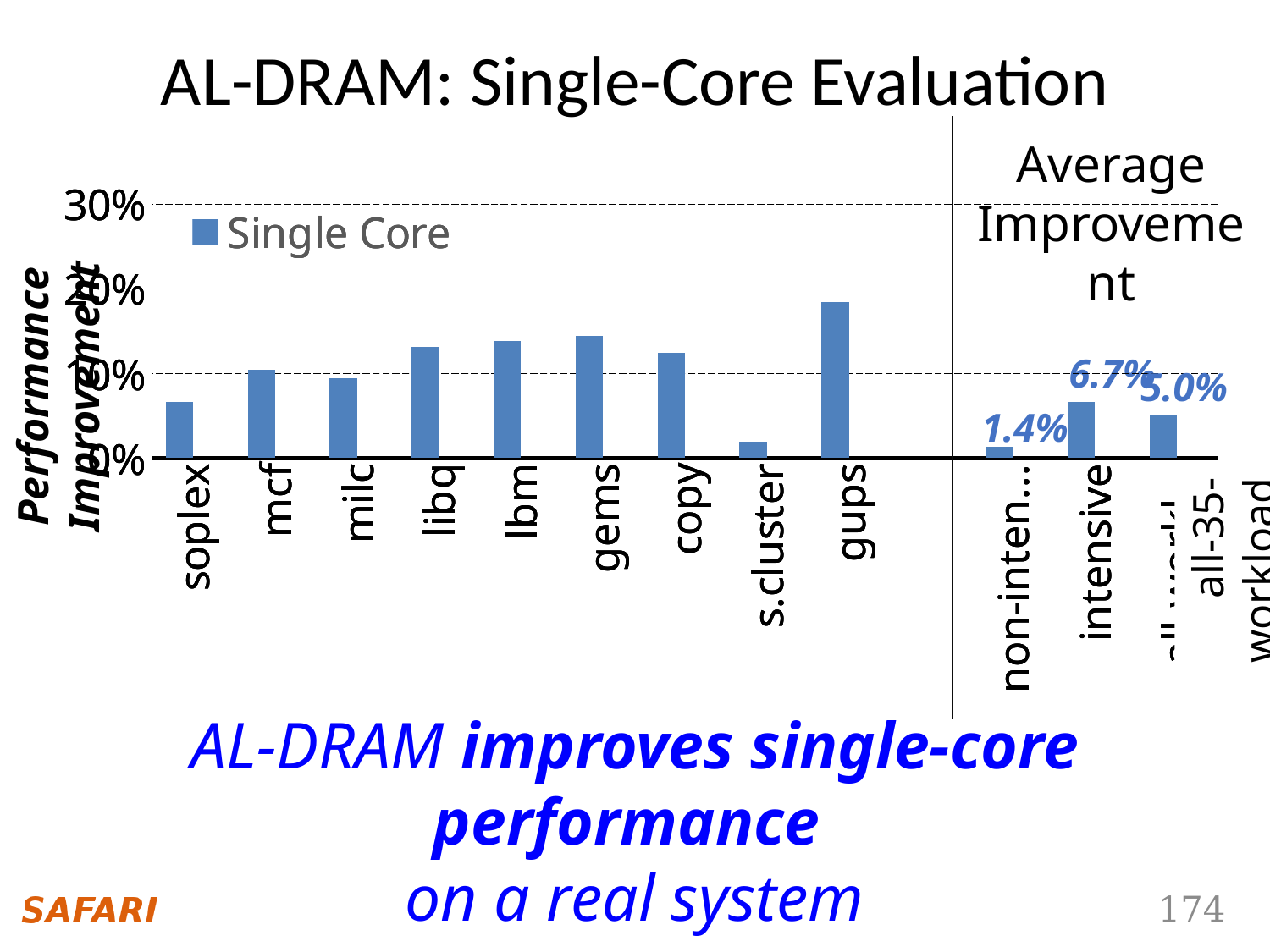
What is the performance improvement for the all-35-workload average? 5.0% Is the value for s.cluster greater or less than 10%? less Is the value for gups greater or less than 10%? greater Which of the three average categories has the lowest performance improvement? non-intensive What is the name of the series shown in the legend? Single Core Which workload has the highest single-core performance improvement? gups Which is larger, the intensive average improvement or the all-35-workload average improvement? intensive How many series does the legend list? 1 What type of chart is shown on the slide? bar chart What is the performance improvement for the non-intensive average? 1.4% What is the difference between the intensive and non-intensive average improvements? 5.3% What is the performance improvement for the intensive average? 6.7%